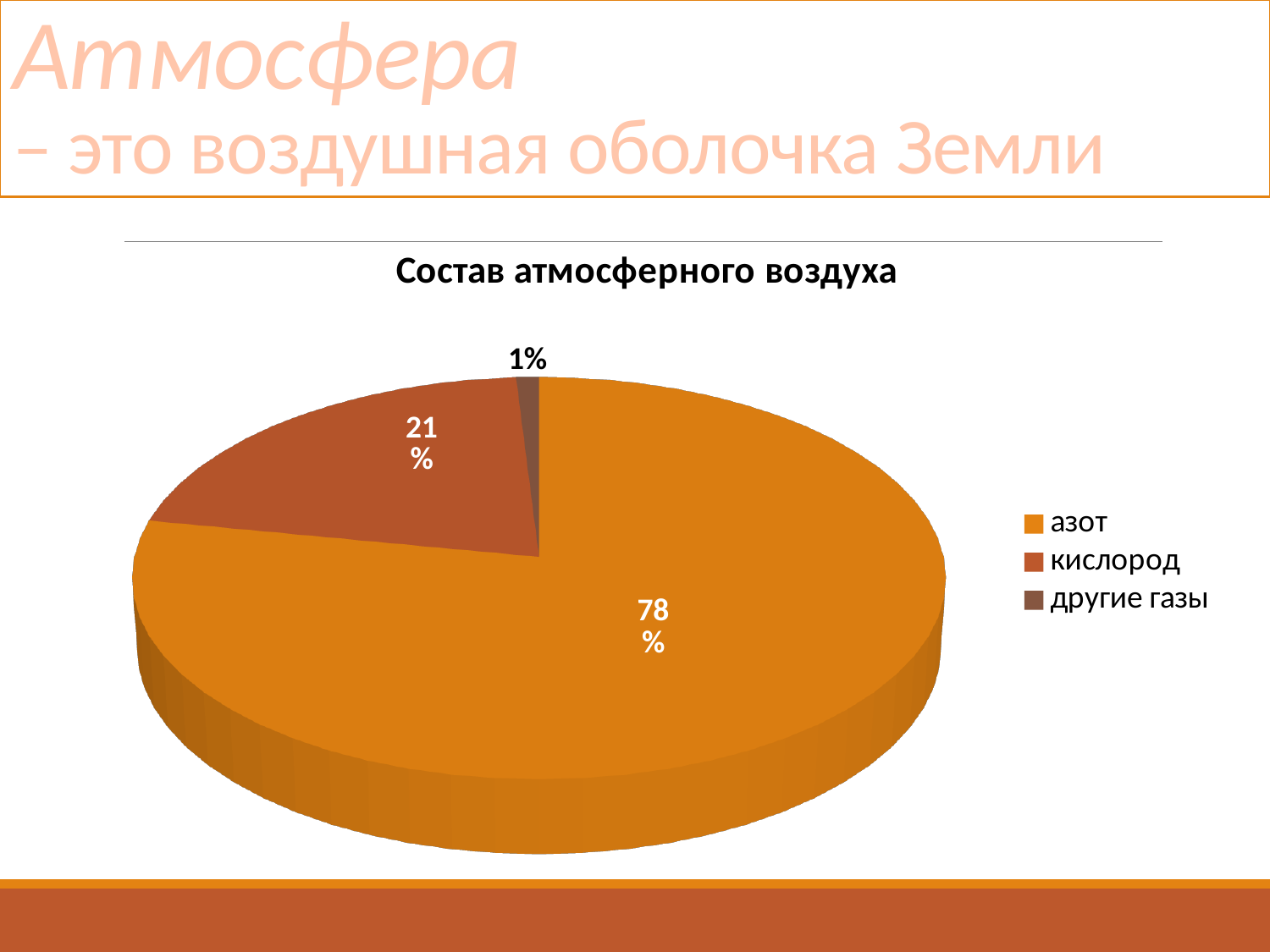
Which is larger, the share of кислород or the share of другие газы? кислород What kind of chart is shown on the slide? pie chart Which category has the largest slice of the pie? азот How many slices does the pie chart have? 3 What is the title of the chart? Состав атмосферного воздуха What share of the pie does кислород have? 21% What share of the pie does другие газы have? 1% What is the difference between the shares of азот and кислород? 57% What is the difference between the shares of кислород and другие газы? 20% How many entries does the legend list? 3 Which category has the smallest slice of the pie? другие газы What share of the pie does азот have? 78%